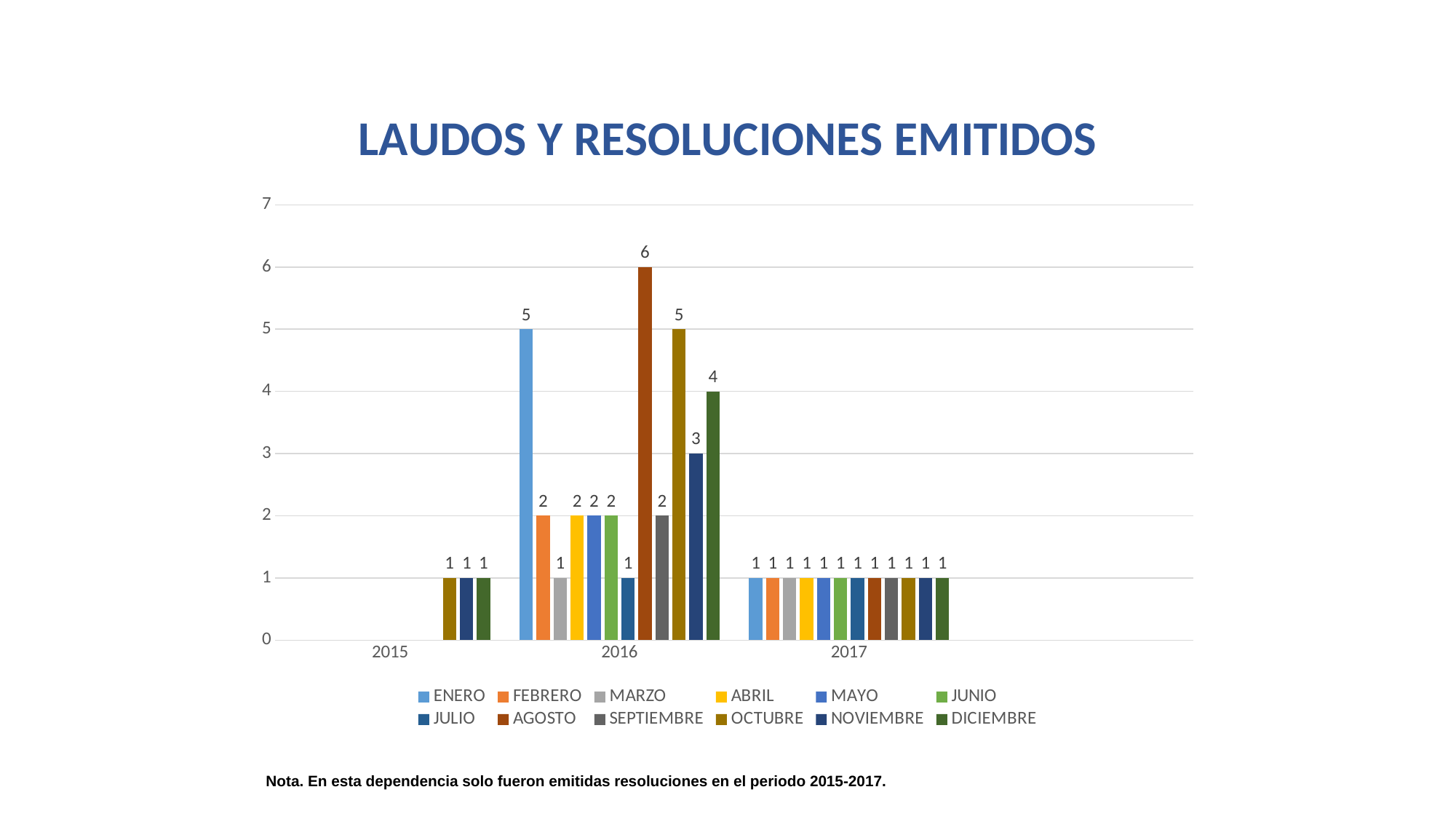
What is the value for DICIEMBRE in 2016? 4 How many series does the legend list? 12 What is the value for ENERO in 2016? 5 How many year categories are shown on the x axis? 3 What is the value for OCTUBRE in 2015? 1 What is the value for MAYO in 2017? 1 What type of chart is shown on the slide? bar chart Which month has the highest value in 2016? AGOSTO What is the difference between the AGOSTO and NOVIEMBRE values in 2016? 3 Which is larger in 2016, the value for OCTUBRE or the value for DICIEMBRE? OCTUBRE What is the value for AGOSTO in 2016? 6 What is the title of the chart? LAUDOS Y RESOLUCIONES EMITIDOS